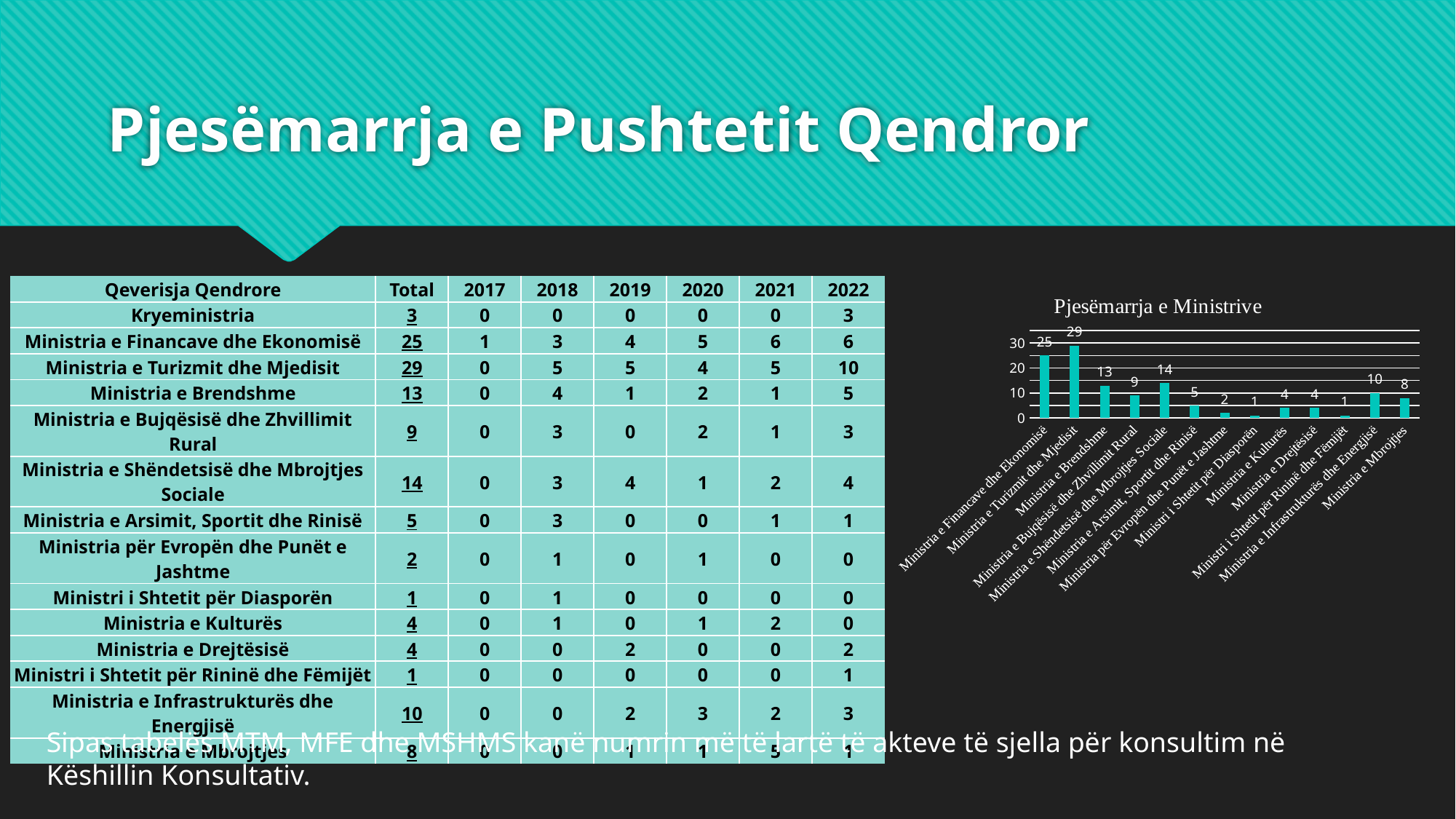
What is the title of the chart on the slide? Pjesëmarrja e Ministrive What is the value for Ministria e Infrastrukturës dhe Energjisë in the chart? 10 What is the value for Ministria e Mbrojtjes in the chart? 8 What is the value for Ministria e Turizmit dhe Mjedisit in the chart? 29 What is the difference between the values for Ministria e Turizmit dhe Mjedisit and Ministria e Financave dhe Ekonomisë? 4 What is the value for Ministria e Financave dhe Ekonomisë in the chart? 25 How many ministries (categories) are plotted in the chart? 13 What is the difference between the values for Ministria e Infrastrukturës dhe Energjisë and Ministria e Arsimit, Sportit dhe Rinisë? 5 What kind of chart is shown on the slide? bar chart Which ministry has the highest value in the chart? Ministria e Turizmit dhe Mjedisit Which is larger in the chart: the value for Ministria e Brendshme or the value for Ministria e Shëndetsisë dhe Mbrojtjes Sociale? Ministria e Shëndetsisë dhe Mbrojtjes Sociale Is the value for Ministria e Bujqësisë dhe Zhvillimit Rural greater or less than 10? less